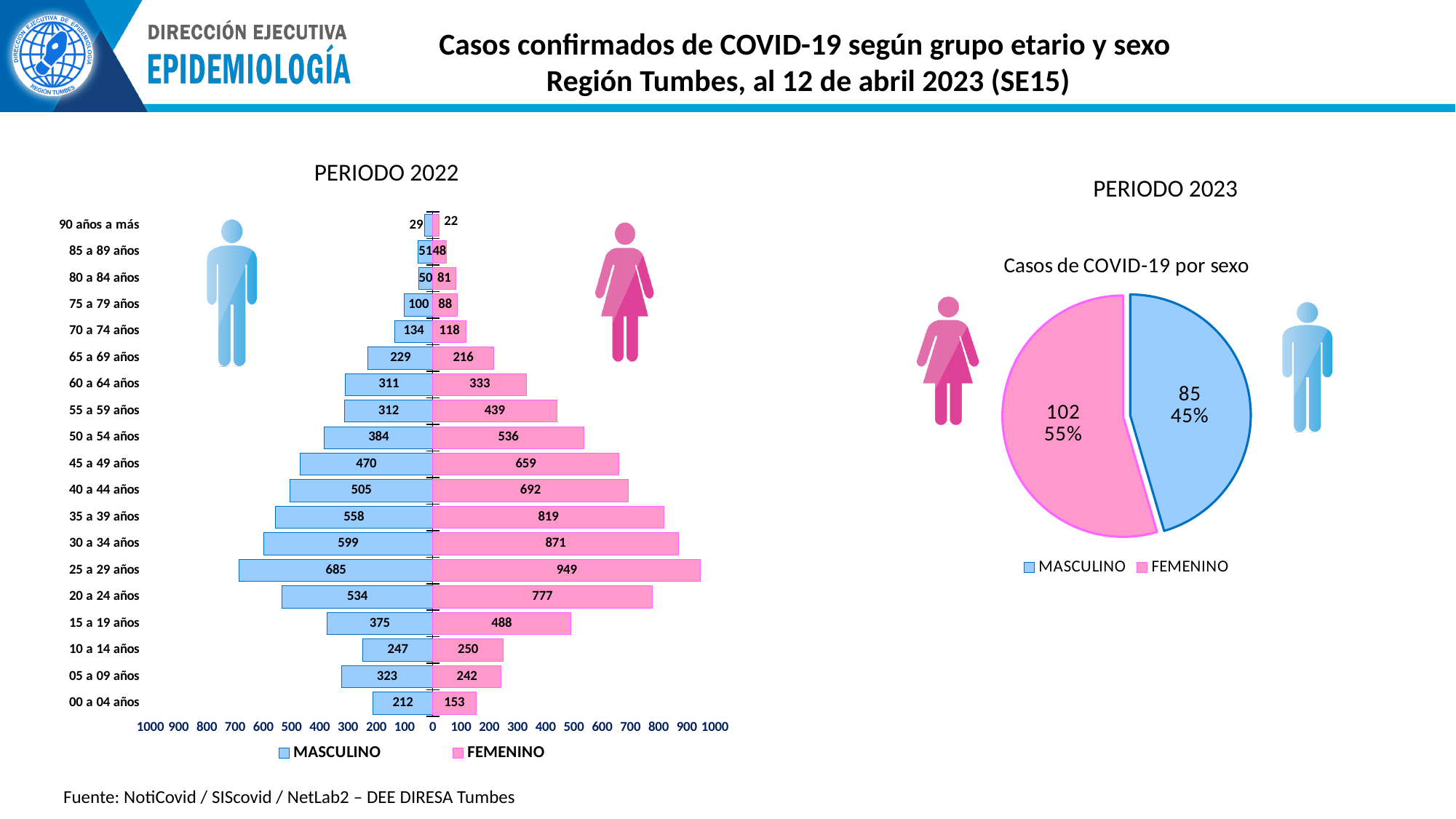
How many series does the legend of the PERIODO 2022 chart list? 2 How many age groups are shown in the PERIODO 2022 chart? 19 In the PERIODO 2022 chart, which is larger for the 05 a 09 años age group, MASCULINO or FEMENINO? MASCULINO What kind of chart is the PERIODO 2022 chart? Bar chart In the PERIODO 2023 pie chart, what share of cases is FEMENINO? 55% In the PERIODO 2022 chart, what is the difference between the FEMENINO and MASCULINO values for the 30 a 34 años age group? 272 In the PERIODO 2022 chart, what is the FEMENINO value for the 25 a 29 años age group? 949 In the PERIODO 2023 pie chart, what is the MASCULINO value? 85 What is the title of the pie chart on the right of the slide? Casos de COVID-19 por sexo In the PERIODO 2022 chart, what is the MASCULINO value for the 45 a 49 años age group? 470 In the PERIODO 2022 chart, which age group has the highest FEMENINO value? 25 a 29 años In the PERIODO 2022 chart, which age group has the lowest MASCULINO value? 90 años a más